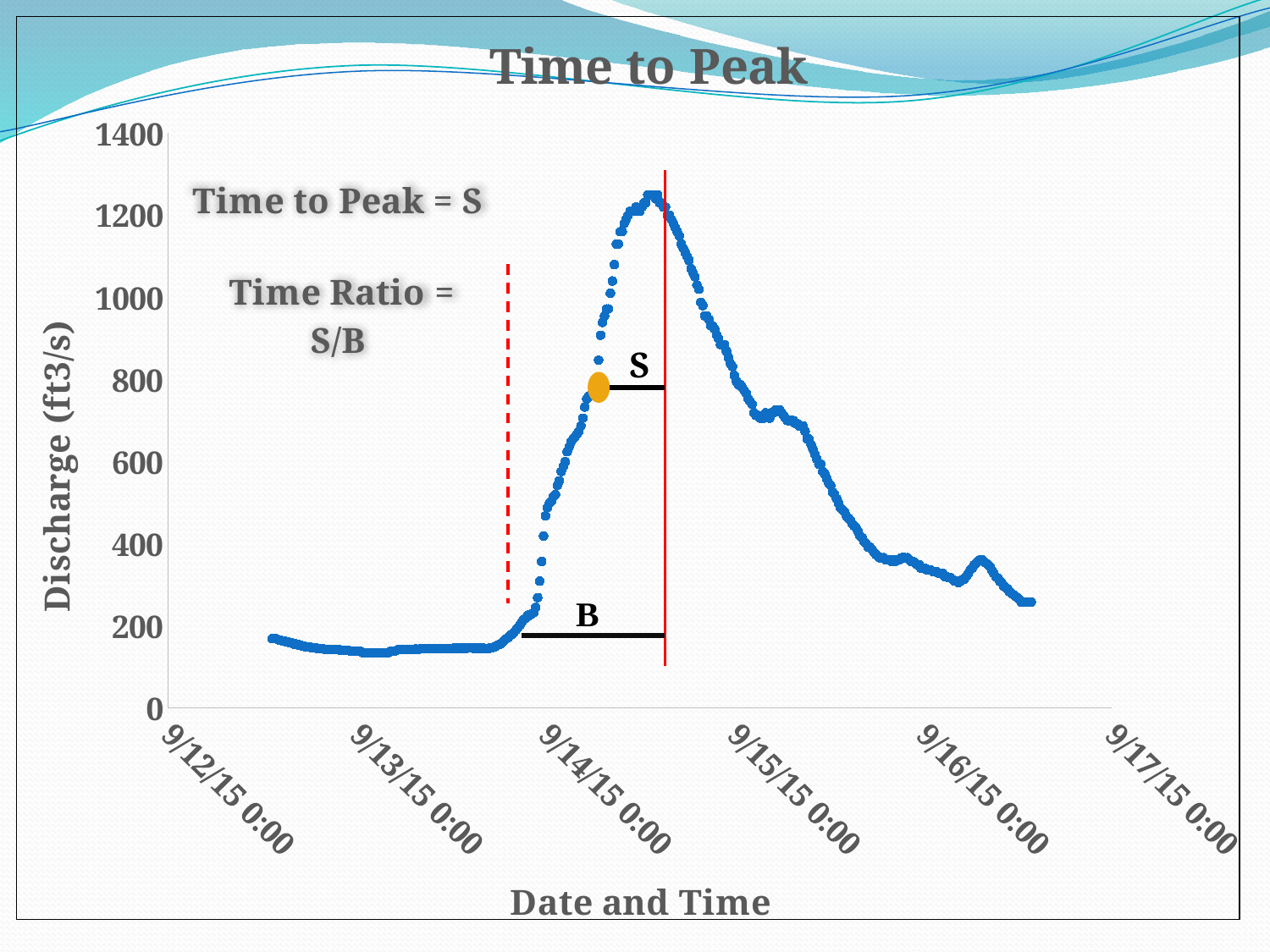
Is the discharge at 9/13/15 0:00 greater or less than 200? less Is the peak discharge value greater or less than 1200? greater Does the discharge rise or fall between 9/15/15 0:00 and 9/16/15 0:00? fall Is the discharge at 9/16/15 0:00 greater or less than 400? less What kind of chart is shown on the slide? scatter chart What is the title of the chart? Time to Peak Does the discharge rise or fall between 9/13/15 0:00 and 9/14/15 0:00? rise What is the label of the vertical axis? Discharge (ft3/s) How many date labels are shown on the horizontal axis? 6